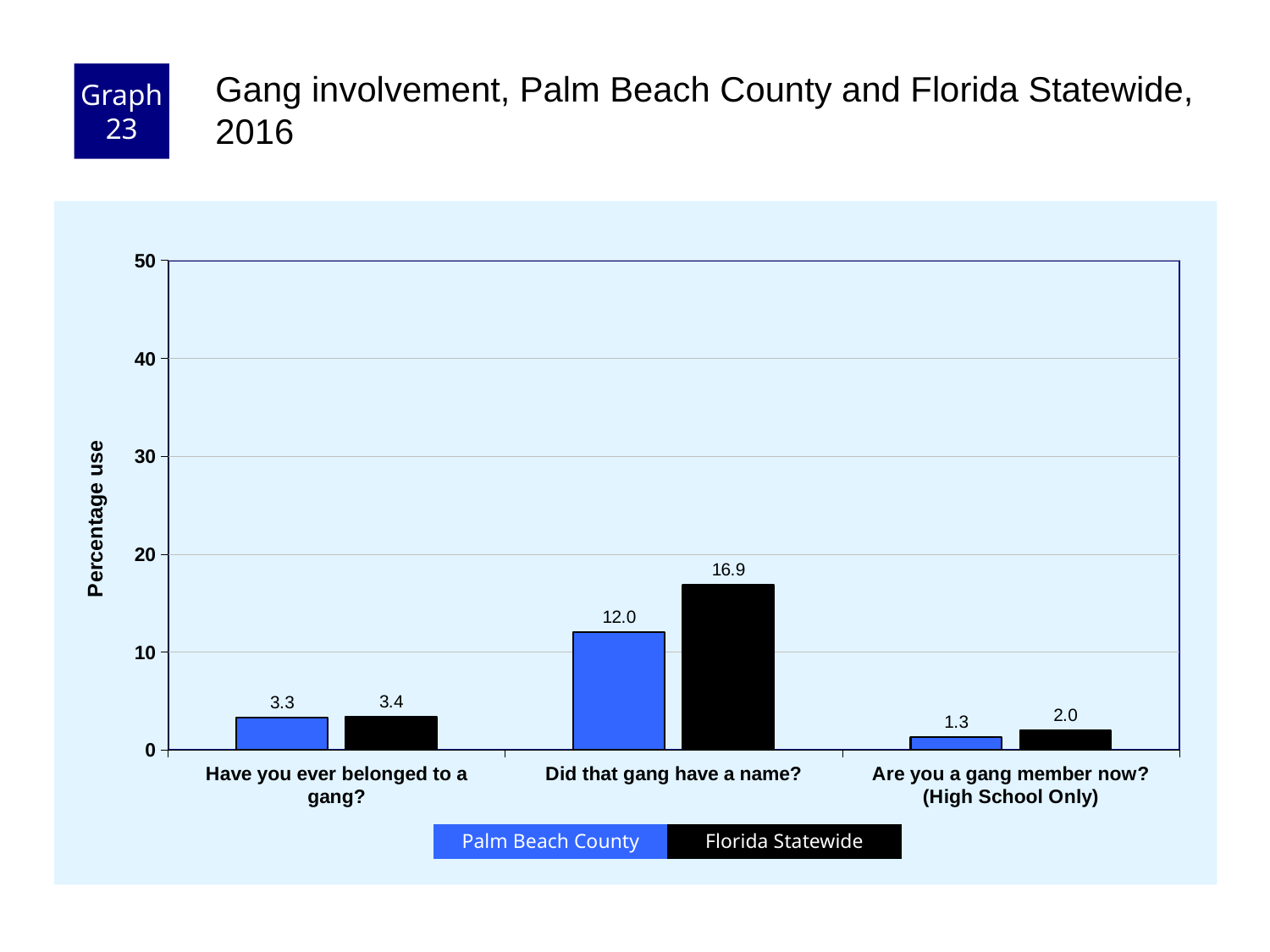
How many series does the legend list? 2 Which question has the lowest Palm Beach County value? Are you a gang member now? (High School Only) What is the Florida Statewide value for "Have you ever belonged to a gang?"? 3.4 What is the label of the y axis? Percentage use What kind of chart is shown on the slide? Bar chart Is the Florida Statewide value for "Did that gang have a name?" greater or less than 20? less For "Are you a gang member now? (High School Only)", which series has the larger value, Palm Beach County or Florida Statewide? Florida Statewide What is the Florida Statewide value for "Are you a gang member now? (High School Only)"? 2.0 Which question has the highest Florida Statewide value? Did that gang have a name? What is the difference between the Florida Statewide and Palm Beach County values for "Did that gang have a name?"? 4.9 What is the Palm Beach County value for "Did that gang have a name?"? 12.0 How many question categories are shown on the x axis? 3